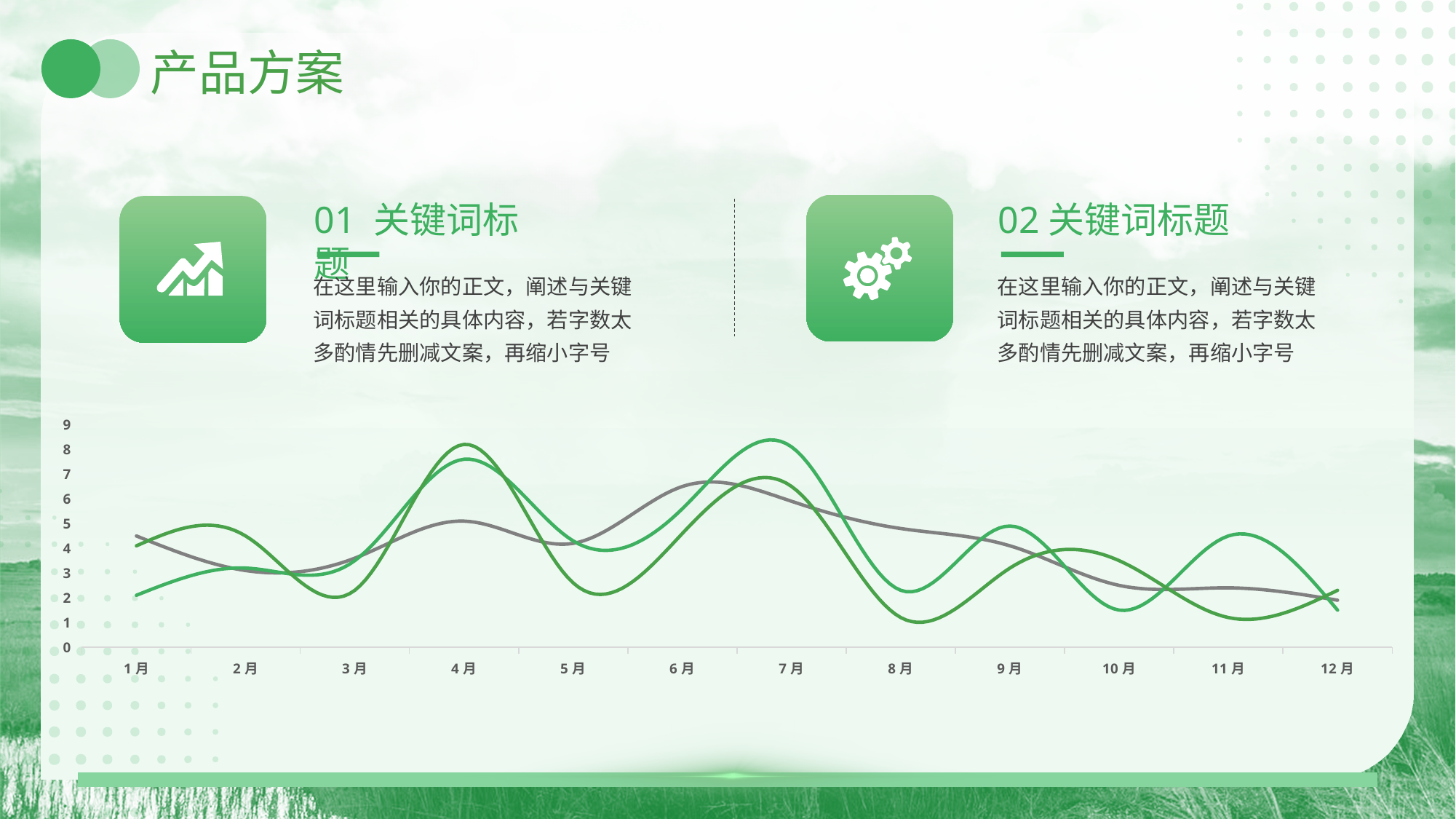
Is the value of the gray line at 12月 greater or less than 4? less What is the highest tick value shown on the y axis of the chart? 9 What kind of chart is shown on the slide? line chart Is the value of the gray line at 4月 greater or less than 7? less What is the first category on the x axis of the chart? 1月 How many months are shown on the x axis of the chart? 12 Is the value of the bright green line at 4月 greater or less than 6? greater How many lines are plotted in the chart? 3